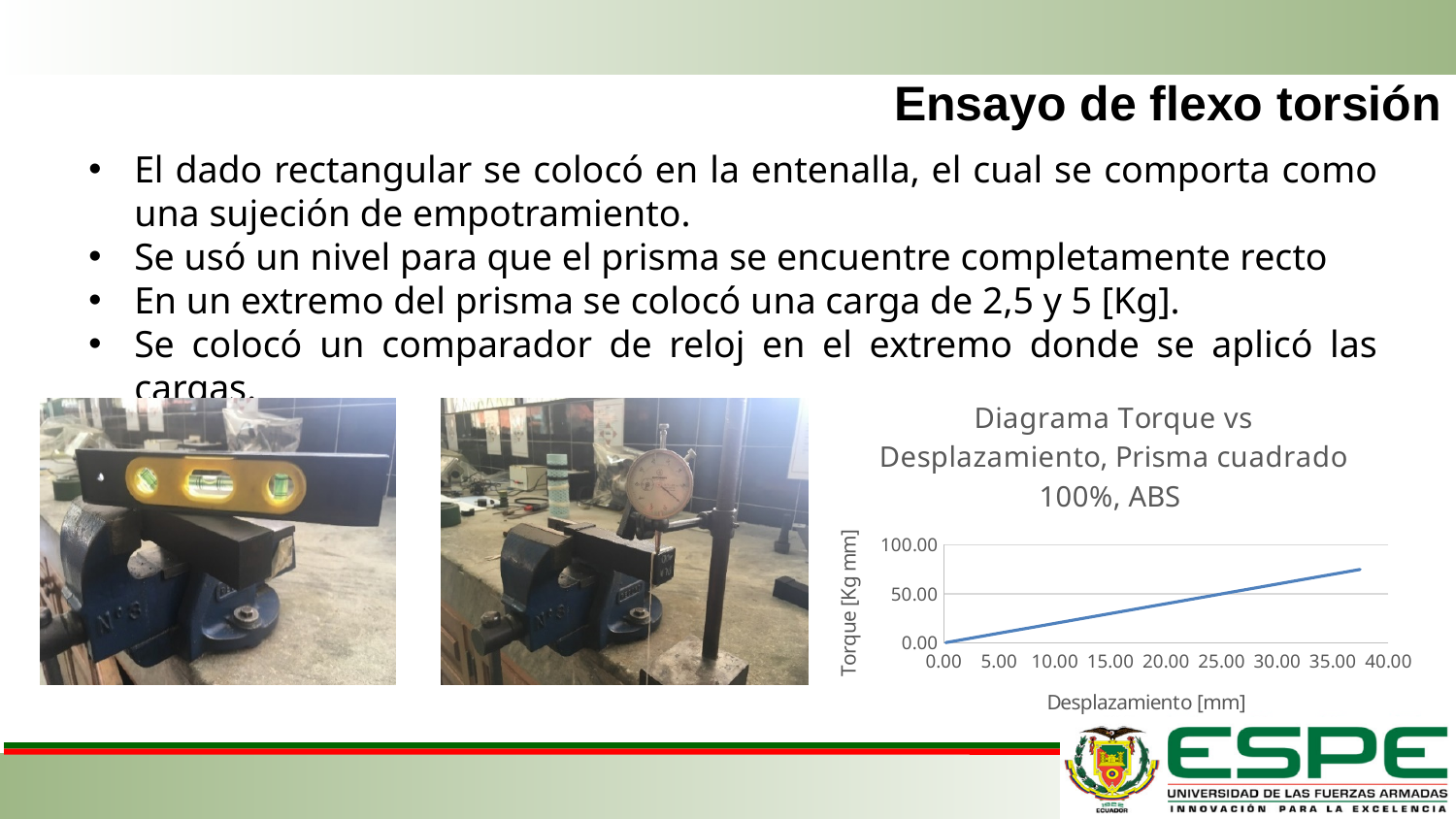
What is the title of the chart on the slide? Diagrama Torque vs Desplazamiento, Prisma cuadrado 100%, ABS Is the torque value at a displacement of 35.00 mm greater or less than 50.00? greater What is the highest tick value shown on the x axis of the chart? 40.00 Is the torque value at a displacement of 10.00 mm greater or less than 50.00? less Is the torque value at a displacement of 20.00 mm greater or less than 50.00? less What is the highest tick value shown on the y axis of the chart? 100.00 What kind of chart is shown on the slide? line chart What is the label of the x axis of the chart? Desplazamiento [mm] Does the torque rise or fall as displacement increases along the x axis? rise